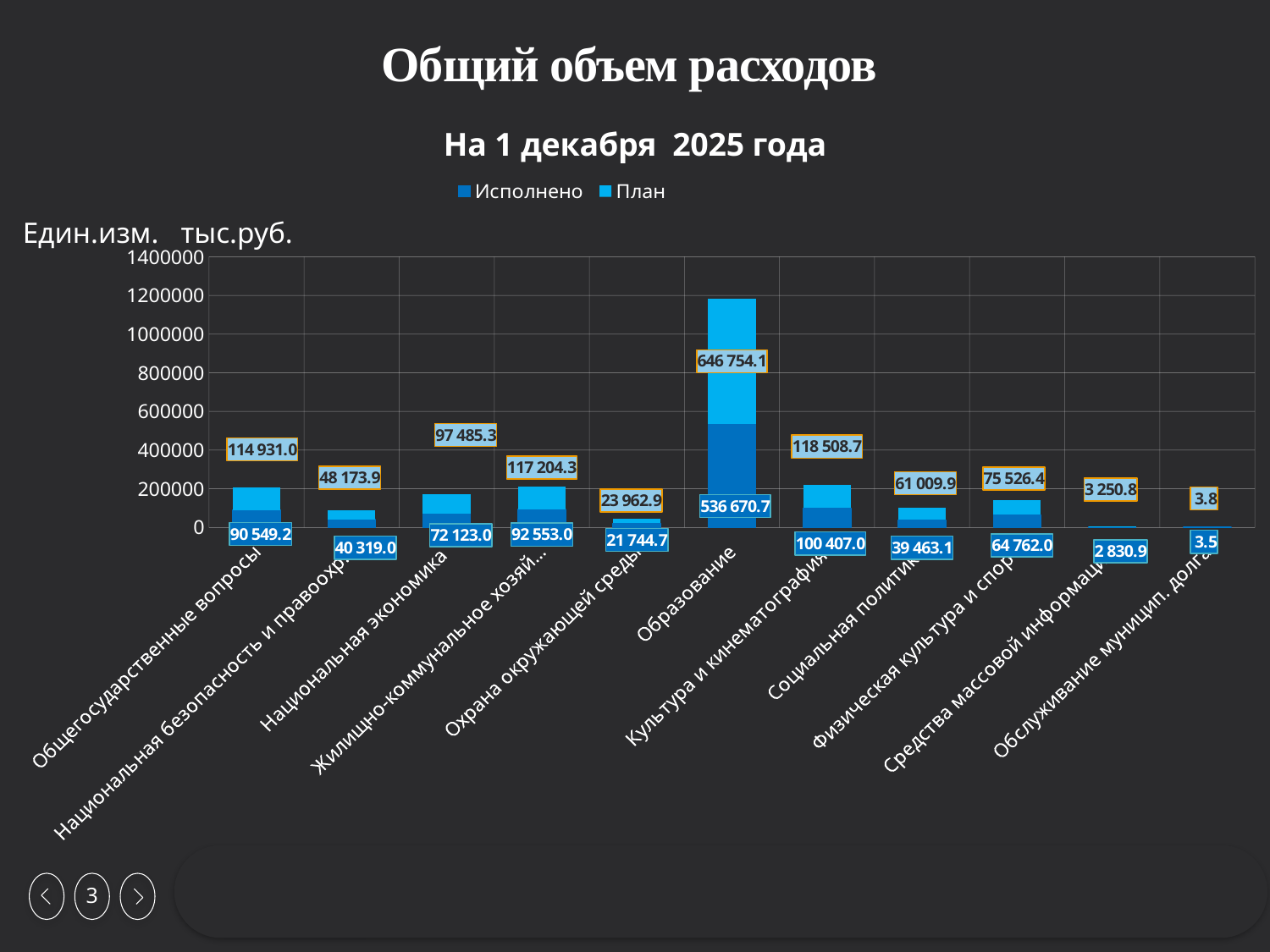
What is the difference between the План and Исполнено values for Образование? 110 083.4 What is the План value for Образование? 646 754.1 What is the Исполнено value for Охрана окружающей среды? 21 744.7 What is the План value for Социальная политика? 61 009.9 Which category has the lowest Исполнено value? Обслуживание муницип. долга What is the Исполнено value for Образование? 536 670.7 How many series does the legend list? 2 Which category has the highest План value? Образование What type of chart is shown on the slide? Stacked bar chart What is the Исполнено value for Национальная экономика? 72 123.0 Which is larger: the Исполнено value for Общегосударственные вопросы or for Культура и кинематография? Культура и кинематография What is the total of the stacked bar for Образование (Исполнено plus План)? 1 183 424.8